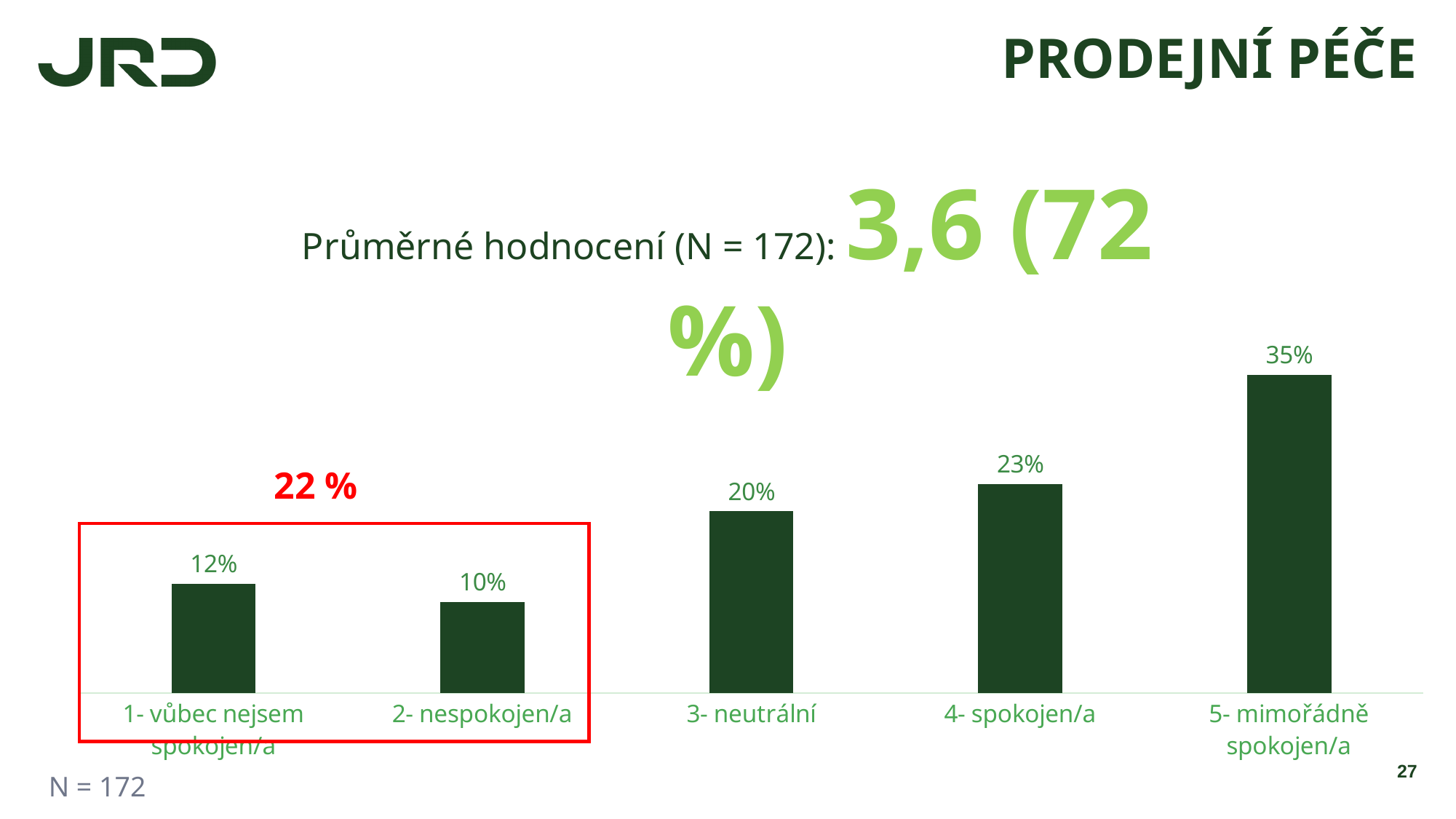
What is the combined value of the two categories inside the red box? 22 % What is the value for "1- vůbec nejsem spokojen/a"? 12% What is the value for "3- neutrální"? 20% What is the difference between the values for "5- mimořádně spokojen/a" and "4- spokojen/a"? 12% What kind of chart is shown on the slide? bar chart Which category has the lowest value? 2- nespokojen/a What is the value for "5- mimořádně spokojen/a"? 35% What is the value for "2- nespokojen/a"? 10% How many categories are shown in the chart? 5 Which is larger, the value for "3- neutrální" or the value for "4- spokojen/a"? 4- spokojen/a What is the average rating (Průměrné hodnocení) shown above the chart? 3,6 (72 %) Which category has the highest value? 5- mimořádně spokojen/a